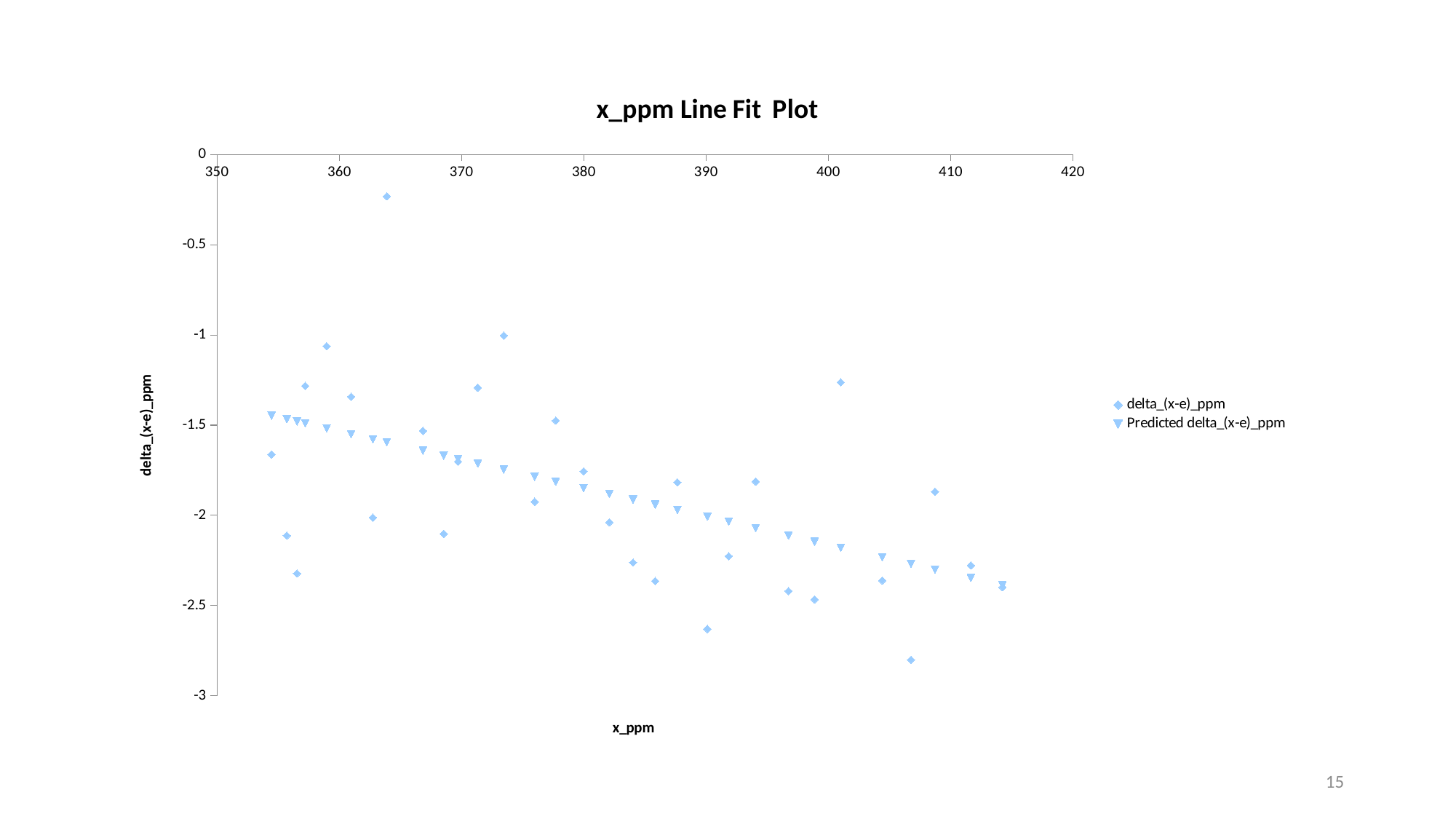
Is the Predicted delta_(x-e)_ppm value at the left end of the series (near x_ppm 354) greater or less than -2? greater What is the maximum value shown on the x axis? 420 Do the Predicted delta_(x-e)_ppm values rise or fall as x_ppm increases? fall Is the highest delta_(x-e)_ppm point on the chart greater or less than -0.5? greater How many series does the legend list? 2 What are the two series named in the legend? delta_(x-e)_ppm and Predicted delta_(x-e)_ppm Is the lowest delta_(x-e)_ppm point on the chart greater or less than -2.5? less What is the title of the chart? x_ppm Line Fit Plot What kind of chart is shown on the slide? scatter plot